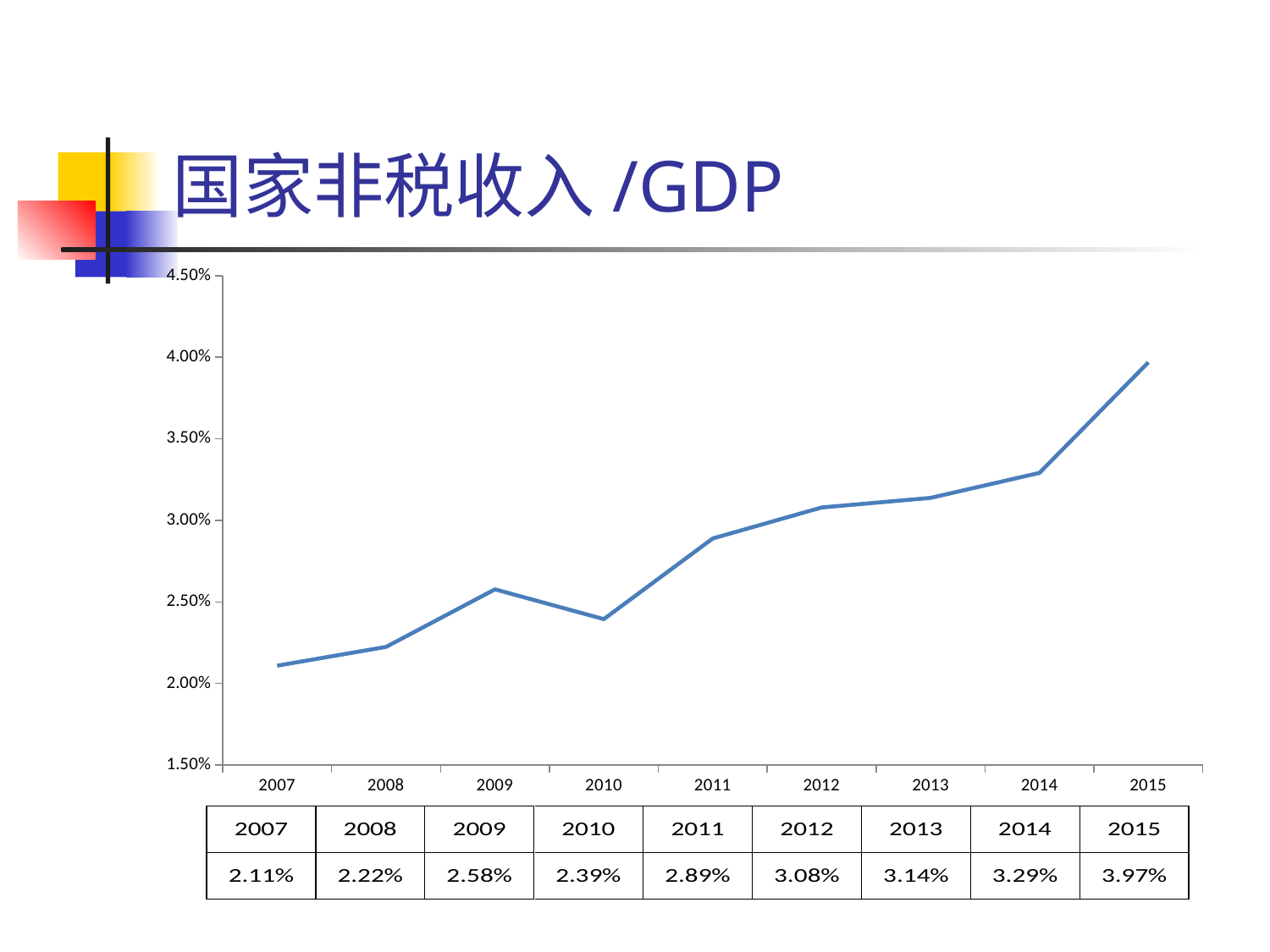
What is the value for 2015? 3.97% Which year has the highest value? 2015 What is the title of the slide? 国家非税收入 /GDP What is the difference between the values for 2015 and 2014? 0.68% How many years are plotted on the x axis? 9 Which year has the lowest value? 2007 What is the value for 2007? 2.11% Which is larger, the value for 2009 or the value for 2010? 2009 What is the difference between the values for 2009 and 2010? 0.19% What is the value for 2010? 2.39% What kind of chart is shown on the slide? line chart Is the value for 2012 greater or less than 3.00%? greater